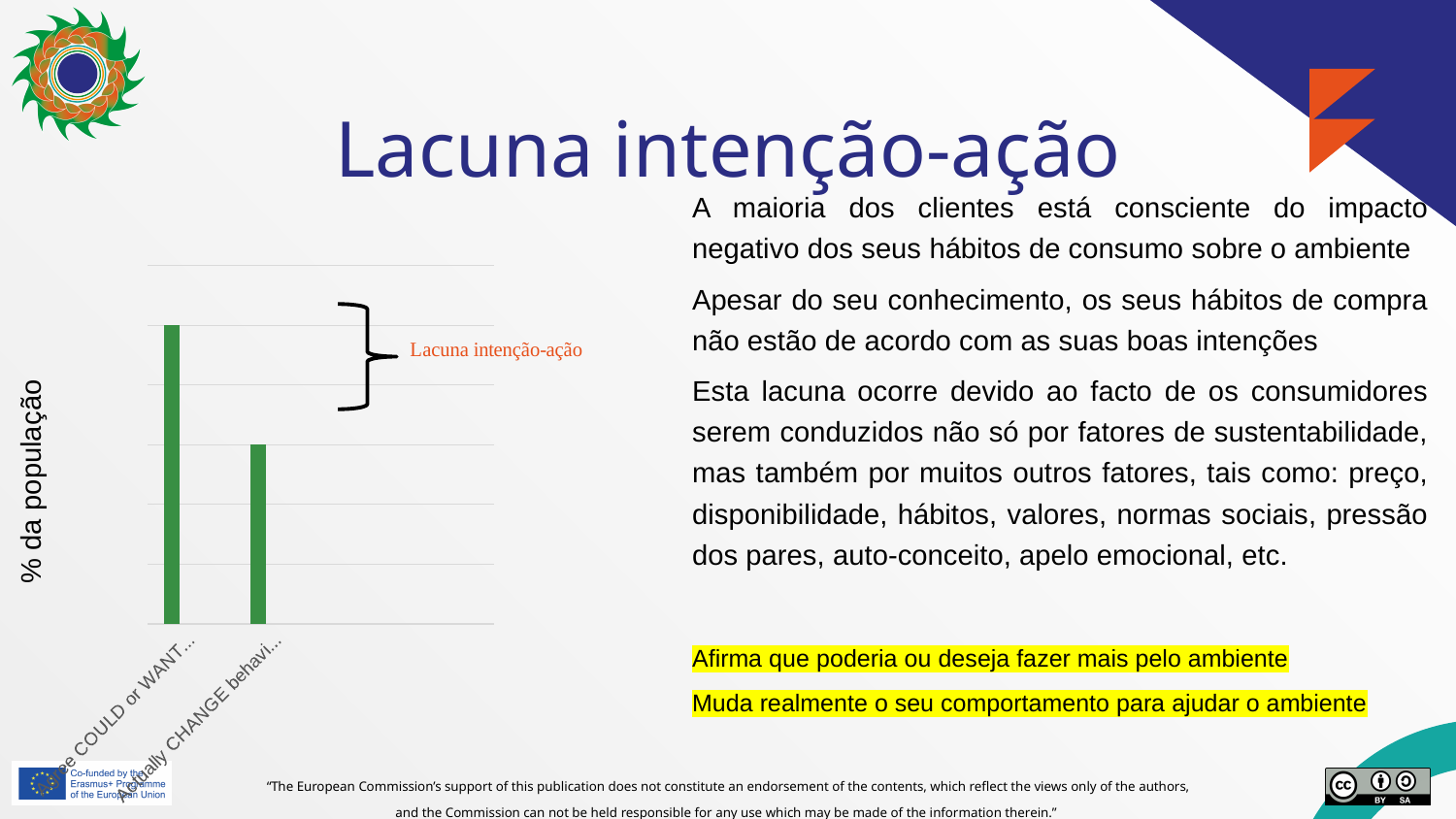
What text does the bracket annotation next to the bars in the chart on the left of the slide read? Lacuna intenção-ação In the chart on the left of the slide, which bar is taller, the left bar or the right bar? the left bar Do the bar heights in the chart on the left of the slide rise or fall from left to right? fall In the chart on the left of the slide, which bar is the tallest? the left bar How many bars does the chart on the left of the slide contain? 2 What kind of chart is shown on the left of the slide? bar chart In the chart on the left of the slide, which bar is the shortest? the right bar What is the label on the vertical axis of the chart on the left of the slide? % da população